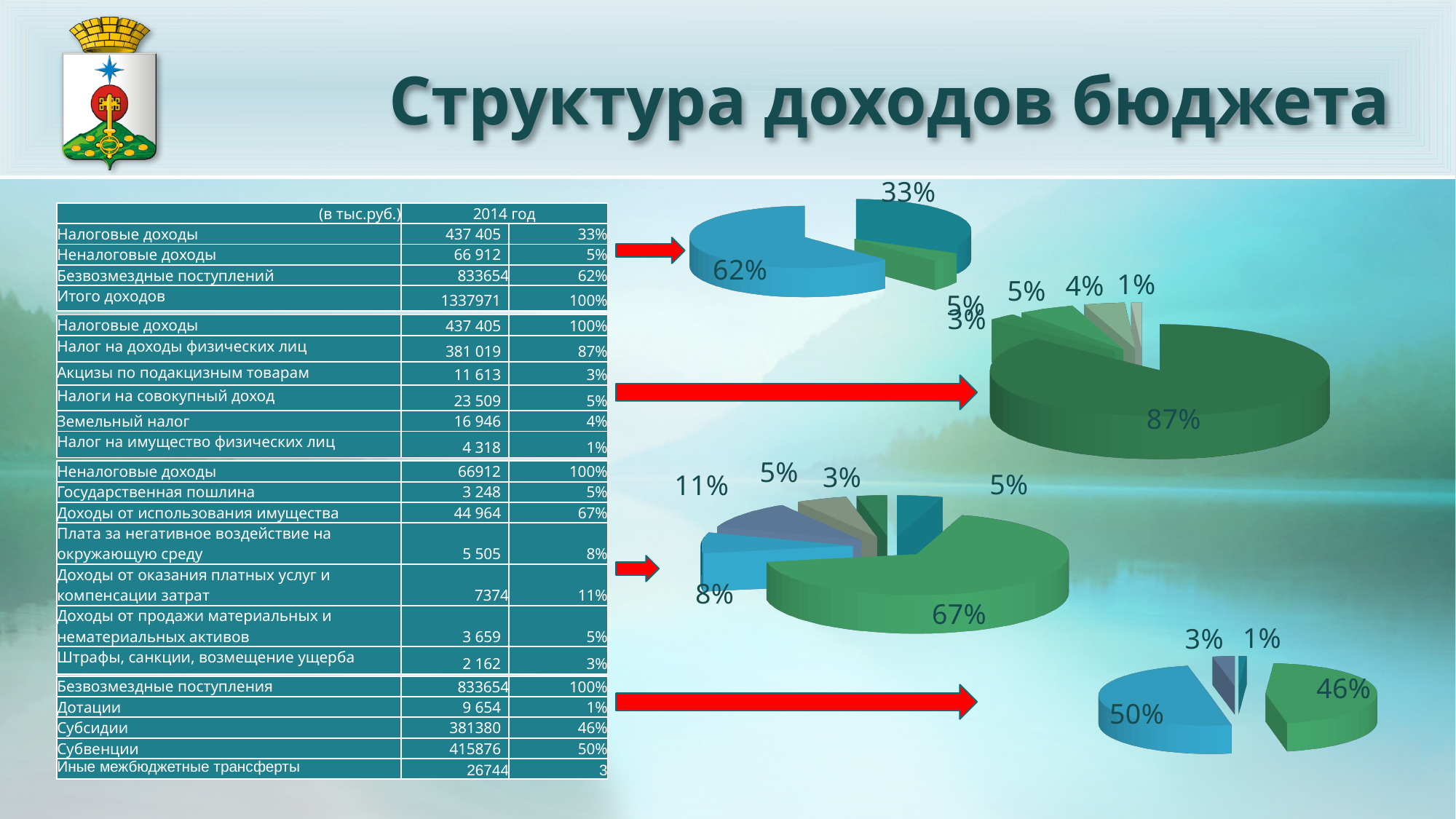
In the large pie chart on the right (second from the top), what is the value of the smallest labelled slice? 1% How many pie charts are shown on the slide? 4 In the top-right pie chart, what is the difference between the slice labelled 62% and the slice labelled 33%? 29 percentage points In the large pie chart on the right (second from the top), what is the value of the largest slice? 87% In the bottom-right pie chart, what is the value of the largest slice? 50% In the top-right pie chart, what is the value of the largest slice? 62% How many slices does the third pie chart from the top (middle of the slide) have? 6 In the bottom-right pie chart, what is the difference between the slice labelled 50% and the slice labelled 46%? 4 percentage points In the bottom-right pie chart, which is larger, the blue slice or the green slice? the blue slice How many slices does the top-right pie chart have? 3 What kind of chart is the top-right chart on the slide? pie chart